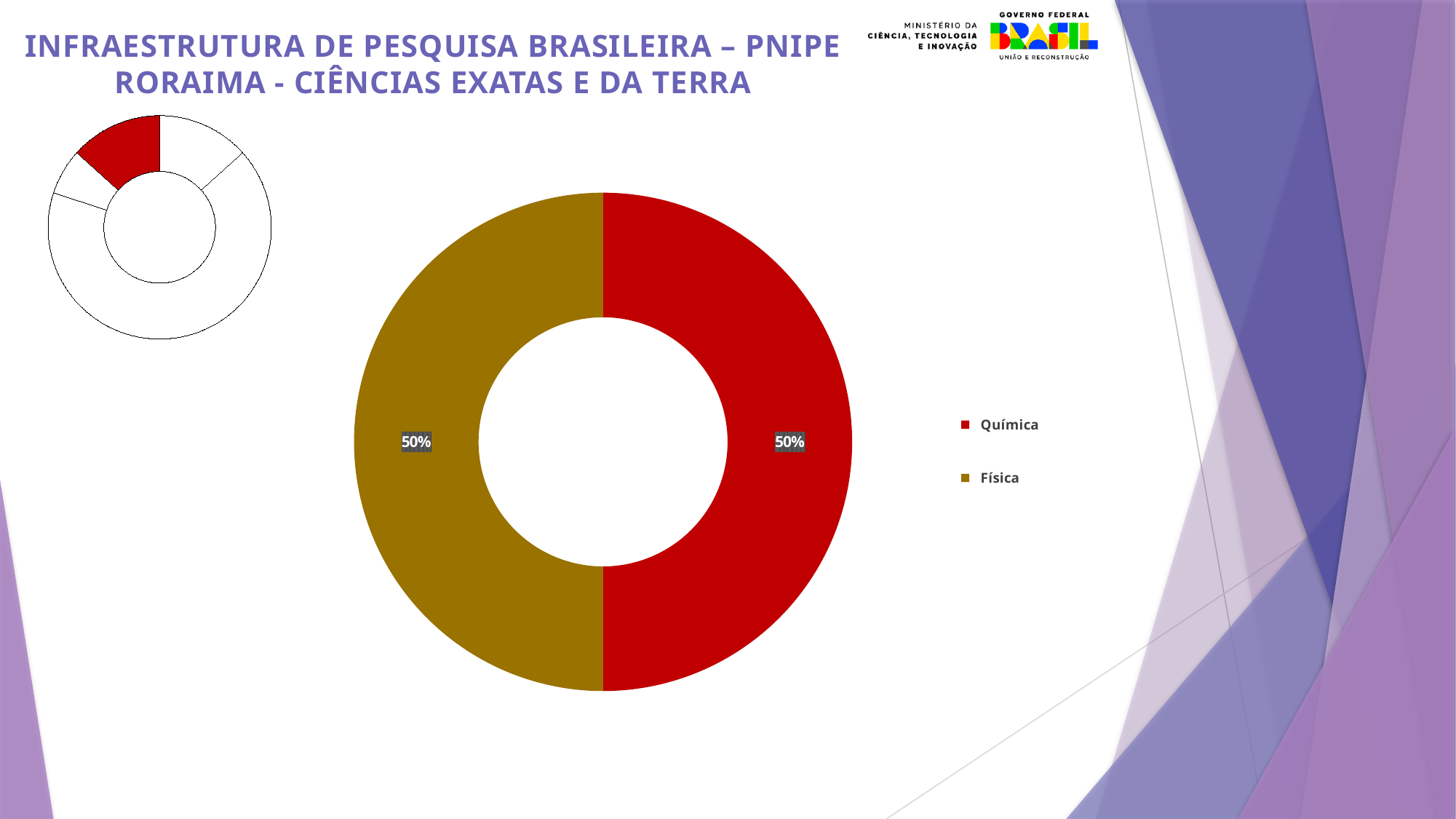
What type of chart is the large chart in the centre of the slide? Doughnut (pie) chart In the large doughnut chart, what percentage is shown for Física? 50% In the large doughnut chart, which colour represents Química? Red In the large doughnut chart, what is the difference between the Química and Física percentages? 0% How many entries does the legend of the large doughnut chart list? 2 How many categories does the large doughnut chart show? 2 In the large doughnut chart, what percentage is shown for Química? 50% In the large doughnut chart, which category is shown in gold/brown? Física In the large doughnut chart, what is the combined share of Química and Física? 100% In the large doughnut chart, what share of the whole does Física represent? 50%